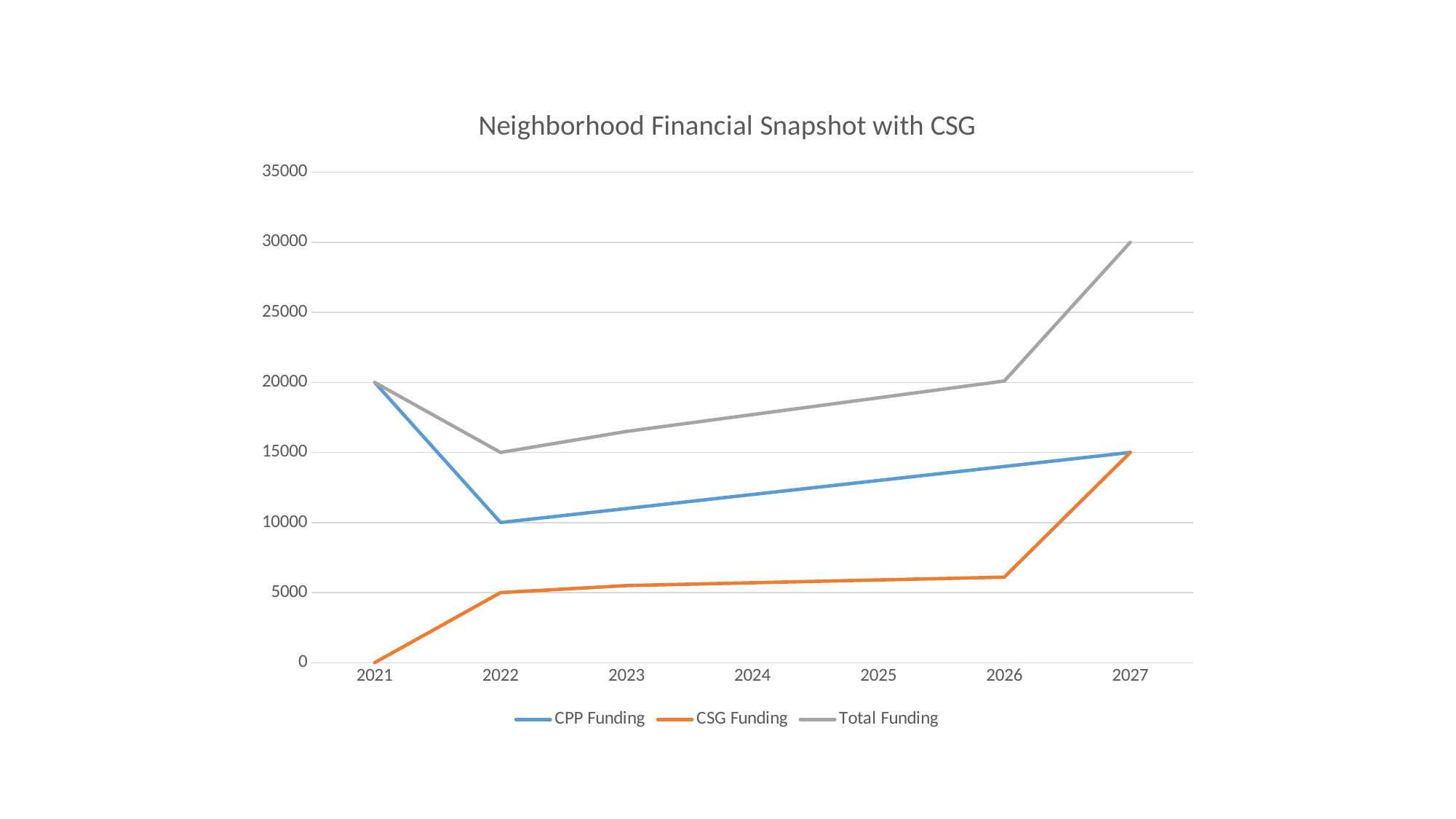
What is the value of CSG Funding in 2022? 5000 What is the value of CPP Funding in 2021? 20000 What is the title of the chart? Neighborhood Financial Snapshot with CSG How many years are shown on the x axis? 7 How many series does the legend list? 3 Does CSG Funding rise or fall from 2021 to 2027? rise In which year is CPP Funding at its lowest? 2022 Is the value of Total Funding in 2026 greater or less than 15000? greater Which is larger in 2022, CPP Funding or CSG Funding? CPP Funding In which year is Total Funding at its highest? 2027 What kind of chart is shown on the slide? line chart What is the value of Total Funding in 2027? 30000